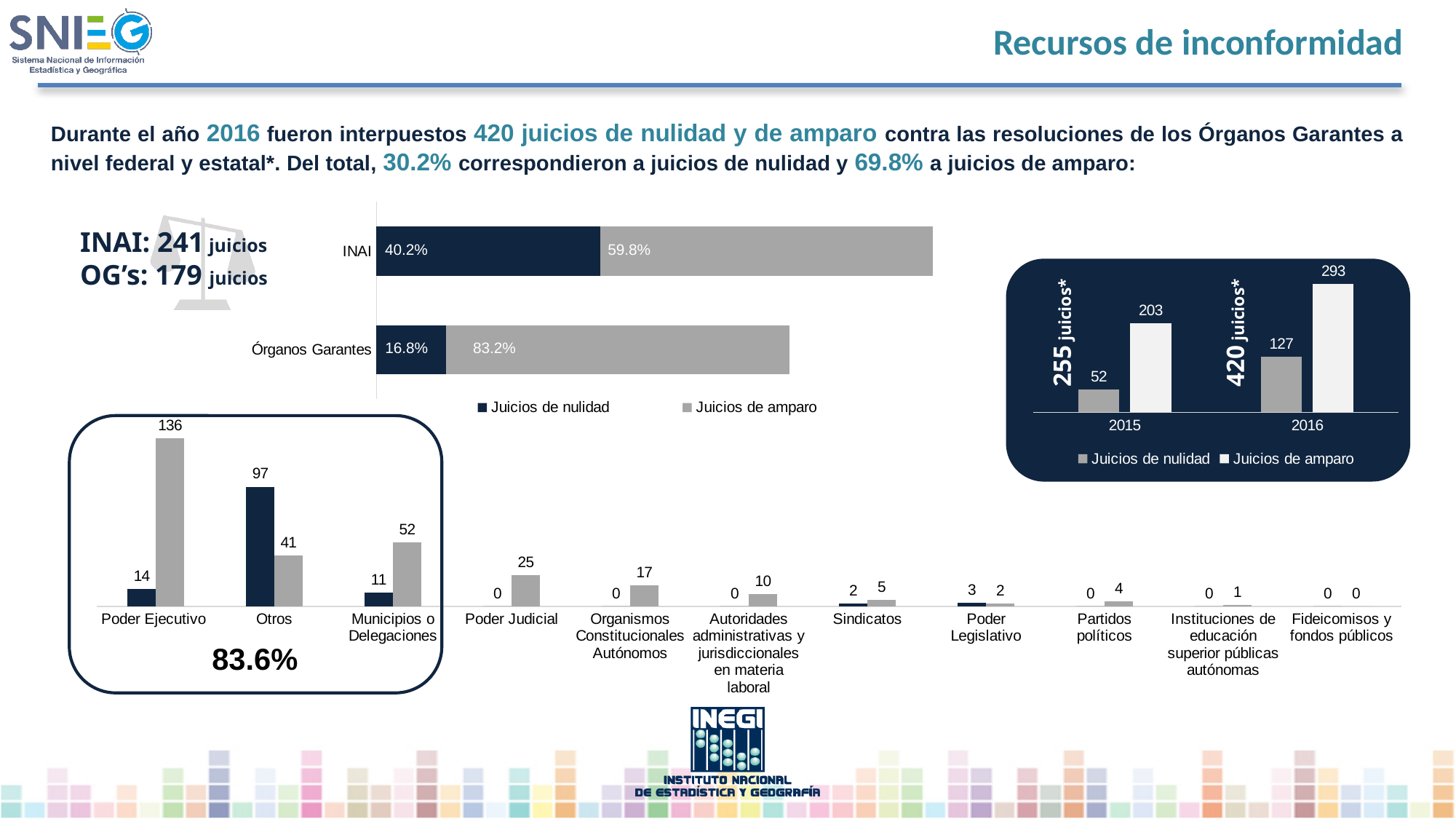
In the horizontal stacked bar chart at the top centre, what percentage of the Órganos Garantes bar corresponds to Juicios de amparo? 83.2% In the horizontal stacked bar chart at the top centre, how many series does the legend list? 2 In the chart inside the dark box on the right, what is the value of Juicios de amparo for 2016? 293 In the bar chart at the bottom of the slide, what is the value of the gray bar for Poder Ejecutivo? 136 In the horizontal stacked bar chart at the top centre, what percentage of the INAI bar corresponds to Juicios de nulidad? 40.2% In the chart inside the dark box on the right, by how much did Juicios de nulidad increase from 2015 to 2016? 75 In the bar chart at the bottom of the slide, which is larger: the dark blue bar for Otros or the gray bar for Poder Ejecutivo? the gray bar for Poder Ejecutivo What kind of chart is shown at the bottom of the slide? bar chart In the bar chart at the bottom of the slide, what is the difference between the gray bar for Poder Judicial and the gray bar for Organismos Constitucionales Autónomos? 8 In the bar chart at the bottom of the slide, which category has the tallest dark blue bar? Otros In the chart inside the dark box on the right, do the Juicios de amparo values rise or fall from 2015 to 2016? rise How many categories are shown on the x axis of the bar chart at the bottom of the slide? 11